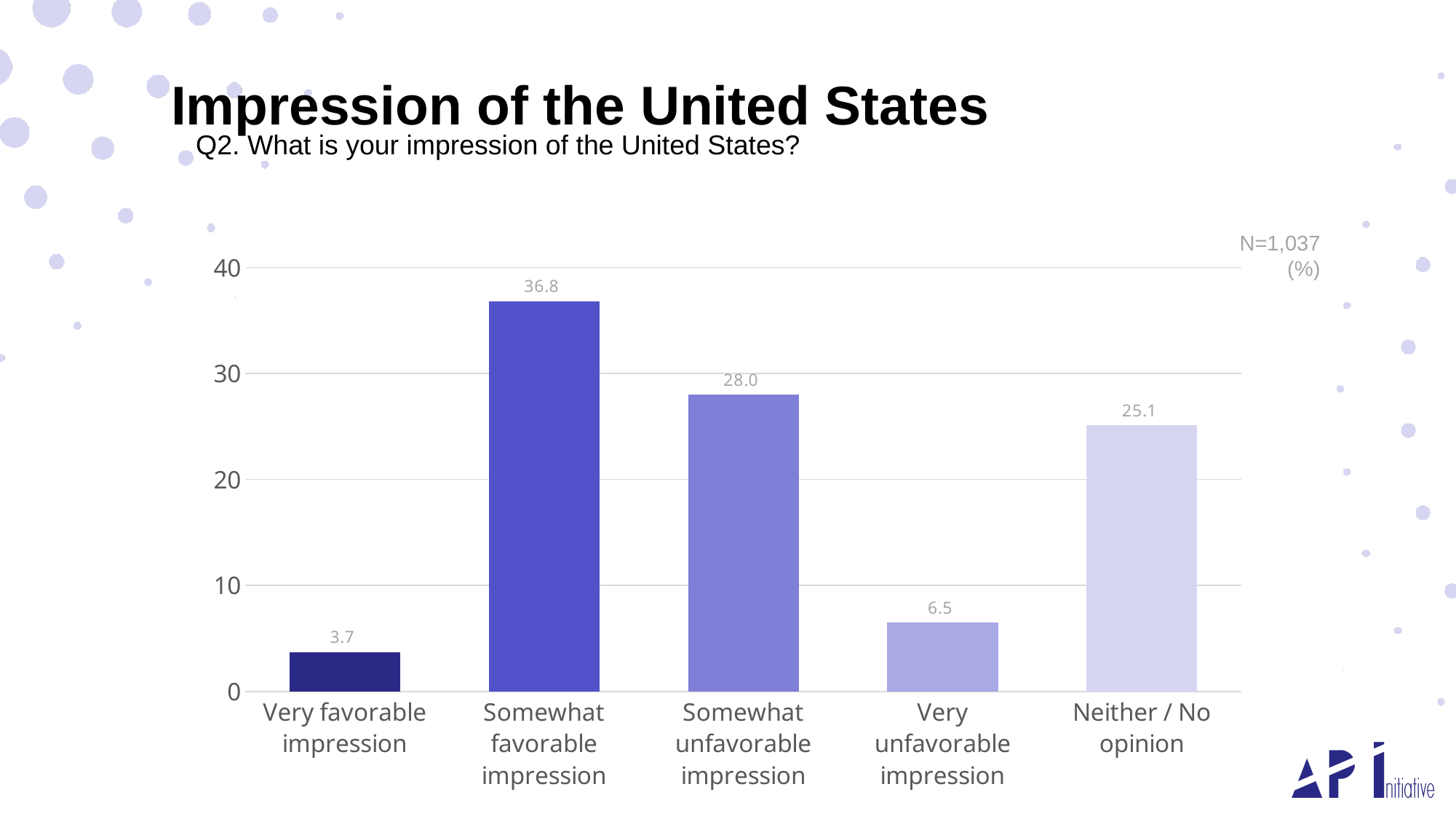
Which is larger: the value for "Somewhat unfavorable impression" or "Neither / No opinion"? Somewhat unfavorable impression Which category has the highest value? Somewhat favorable impression Is the value for "Very unfavorable impression" greater or less than 10? less What kind of chart is shown on the slide? bar chart Which category has the lowest value? Very favorable impression How many categories are shown on the x axis? 5 What is the value for "Very unfavorable impression"? 6.5 What is the value for "Somewhat favorable impression"? 36.8 What is the value for "Neither / No opinion"? 25.1 What is the sample size (N) shown on the chart? N=1,037 What is the difference between the values for "Very unfavorable impression" and "Very favorable impression"? 2.8 What is the difference between the values for "Somewhat favorable impression" and "Somewhat unfavorable impression"? 8.8